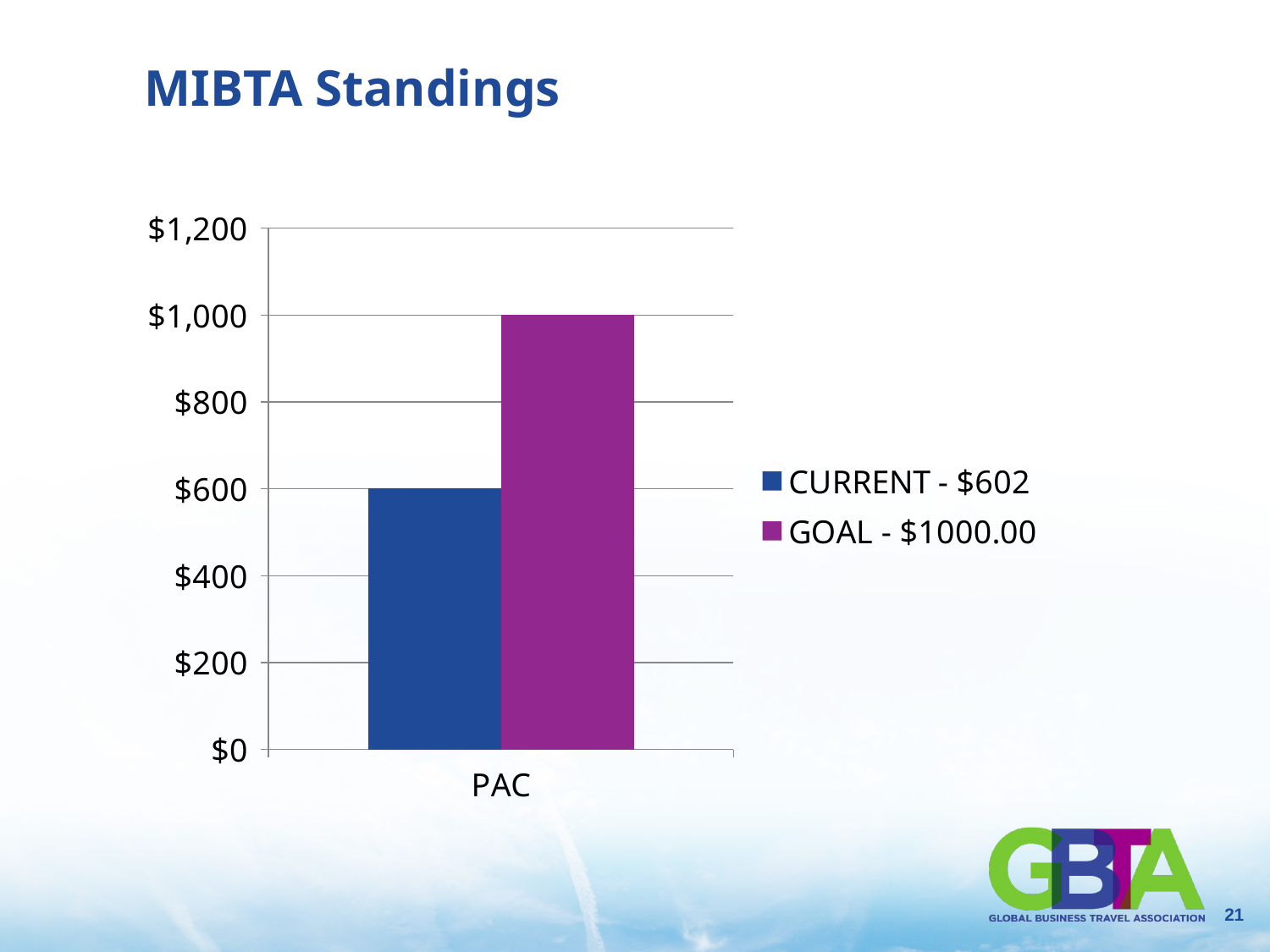
What is the difference between the GOAL value and the CURRENT value for PAC? $398 What is the title of the slide containing the chart? MIBTA Standings Which series has the higher value for PAC, CURRENT or GOAL? GOAL How many categories are shown on the x axis? 1 What kind of chart is shown on the slide? bar chart How many series does the legend list? 2 What colour is the bar for the GOAL series? purple Which series has the lower value for PAC? CURRENT Is the GOAL value for PAC greater or less than $800? greater Is the CURRENT value for PAC greater or less than $800? less What is the value of the GOAL series for PAC? $1000.00 What is the value of the CURRENT series for PAC? $602